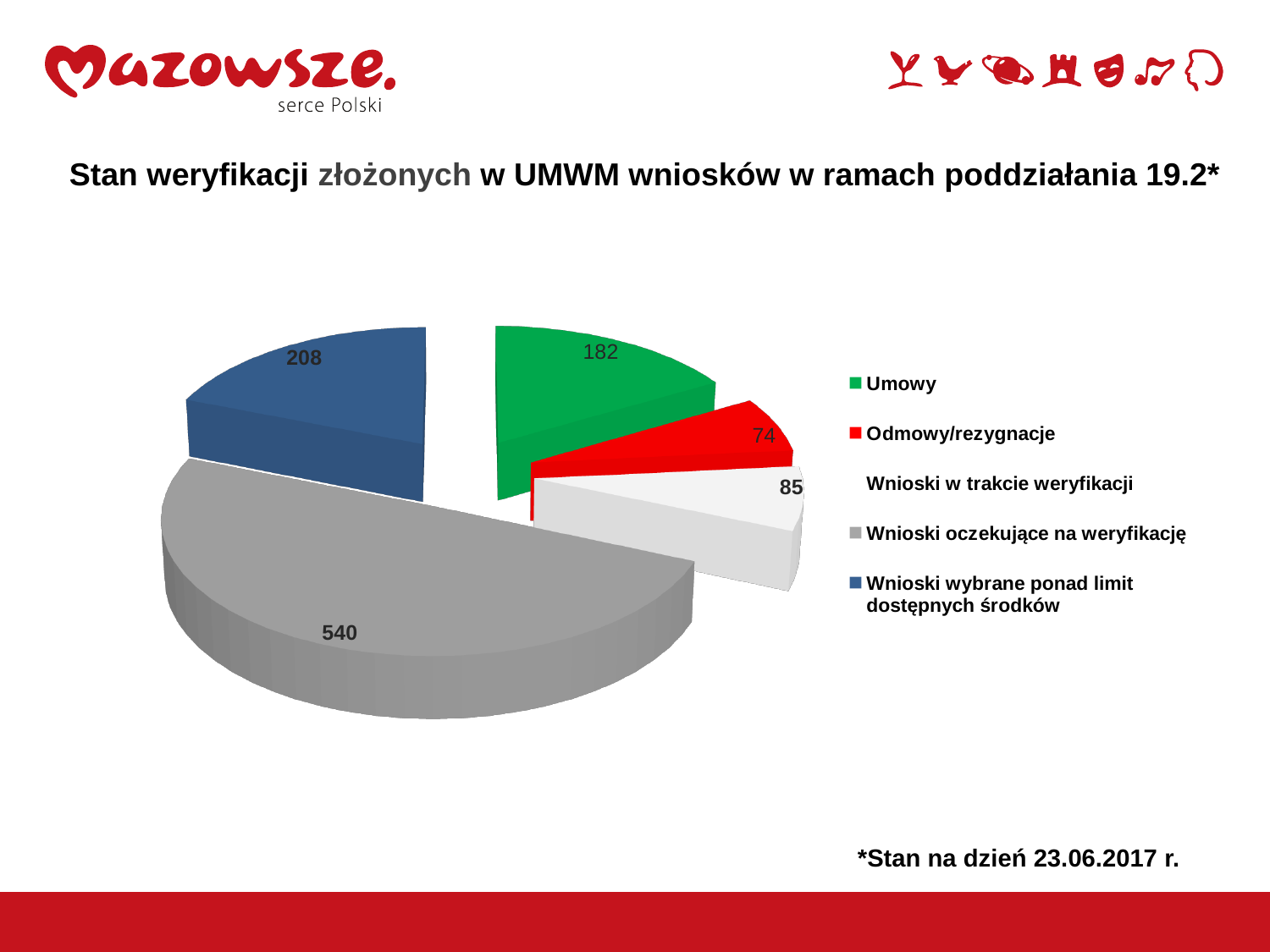
What kind of chart is shown on the slide? Pie chart Which is larger: Umowy or Wnioski w trakcie weryfikacji? Umowy What is the value for Wnioski oczekujące na weryfikację? 540 What is the difference between the values for Wnioski oczekujące na weryfikację and Wnioski wybrane ponad limit dostępnych środków? 332 What is the value for Umowy in the pie chart? 182 What is the value for Wnioski wybrane ponad limit dostępnych środków? 208 What is the value for Odmowy/rezygnacje? 74 Which category has the largest slice of the pie? Wnioski oczekujące na weryfikację What colour is the Umowy slice in the pie chart? Green Which category has the smallest slice of the pie? Odmowy/rezygnacje How many categories does the pie chart show? 5 What is the value for Wnioski w trakcie weryfikacji? 85